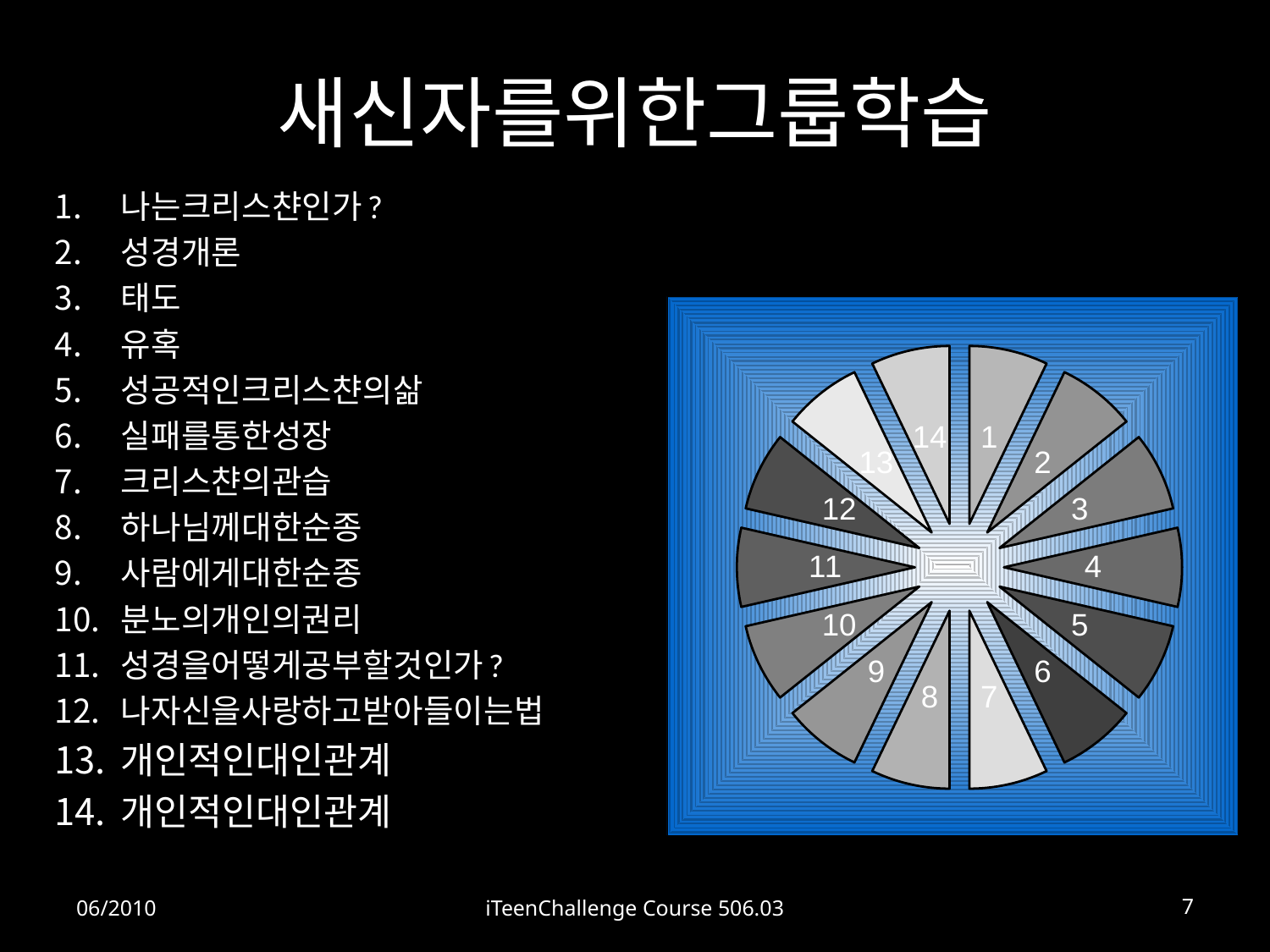
How many slices does the pie chart on the slide have? 14 What is the highest number used as a slice label in the pie chart? 14 Are the slices of the pie chart all roughly the same size, or do they differ noticeably in size? roughly the same size What kind of chart is shown on the right side of the slide? pie chart What label is on the slice at the top right of the pie chart, just right of the top centre? 1